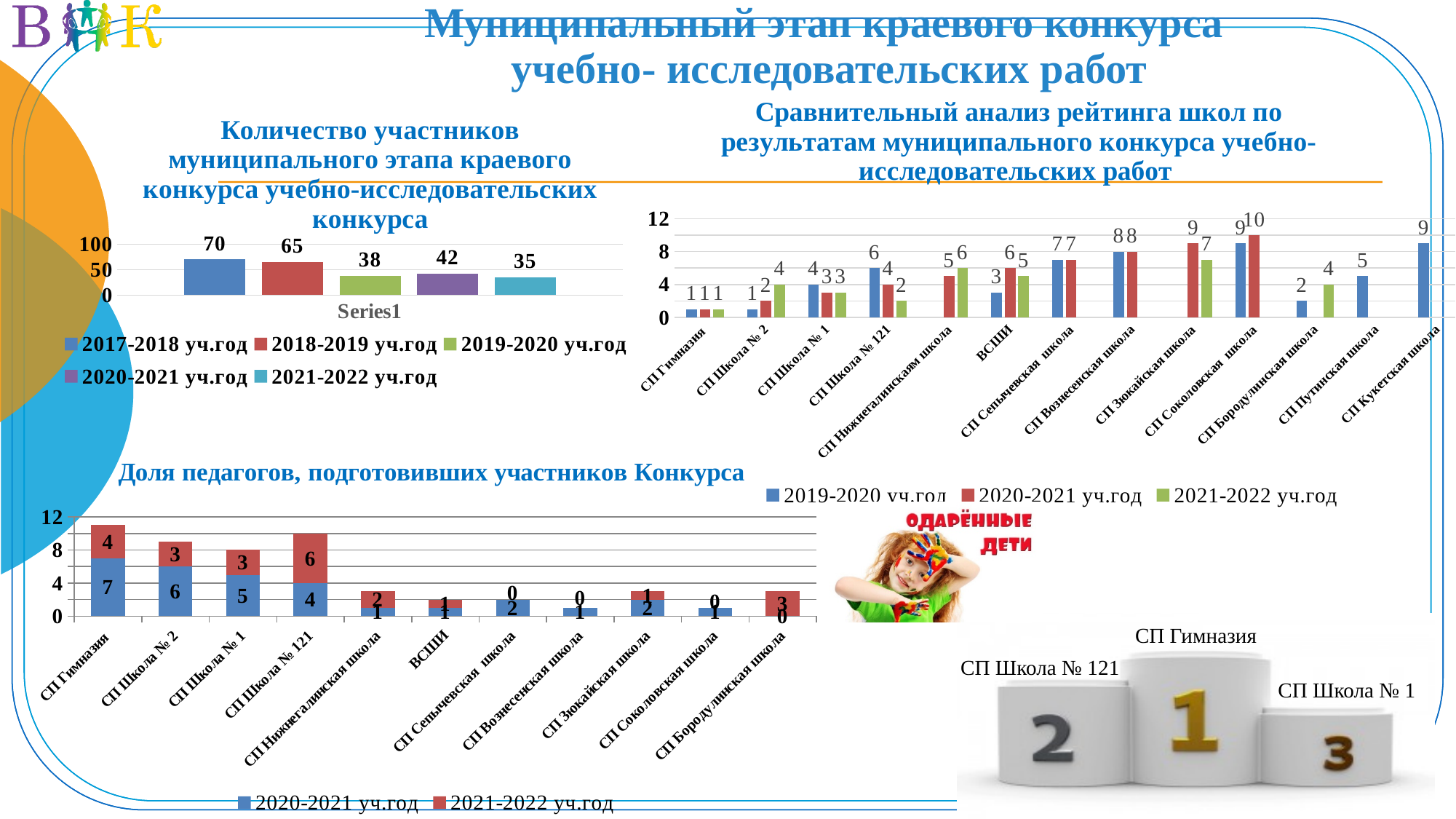
In the chart 'Количество участников муниципального этапа краевого конкурса', what is the difference between the 2017-2018 уч.год and 2018-2019 уч.год values? 5 In the chart 'Сравнительный анализ рейтинга школ', how many schools are shown on the x axis? 13 In the chart 'Количество участников муниципального этапа краевого конкурса', what is the value for 2017-2018 уч.год? 70 In the chart 'Доля педагогов, подготовивших участников Конкурса', what is the total of the stacked bar for СП Гимназия? 11 In the chart 'Сравнительный анализ рейтинга школ', which is larger for СП Школа № 2: the 2019-2020 уч.год value or the 2021-2022 уч.год value? 2021-2022 уч.год In the chart 'Сравнительный анализ рейтинга школ', what is the value for СП Соколовская школа in 2020-2021 уч.год? 10 In the chart 'Доля педагогов, подготовивших участников Конкурса', what is the value for СП Школа № 121 in 2021-2022 уч.год? 6 How many series does the legend of the chart 'Количество участников муниципального этапа краевого конкурса' list? 5 How many series does the legend of the chart 'Доля педагогов, подготовивших участников Конкурса' list? 2 What kind of chart is 'Доля педагогов, подготовивших участников Конкурса'? Stacked bar chart In the chart 'Сравнительный анализ рейтинга школ', what is the value for СП Школа № 121 in 2019-2020 уч.год? 6 In the chart 'Количество участников муниципального этапа краевого конкурса', which series has the lowest value? 2021-2022 уч.год